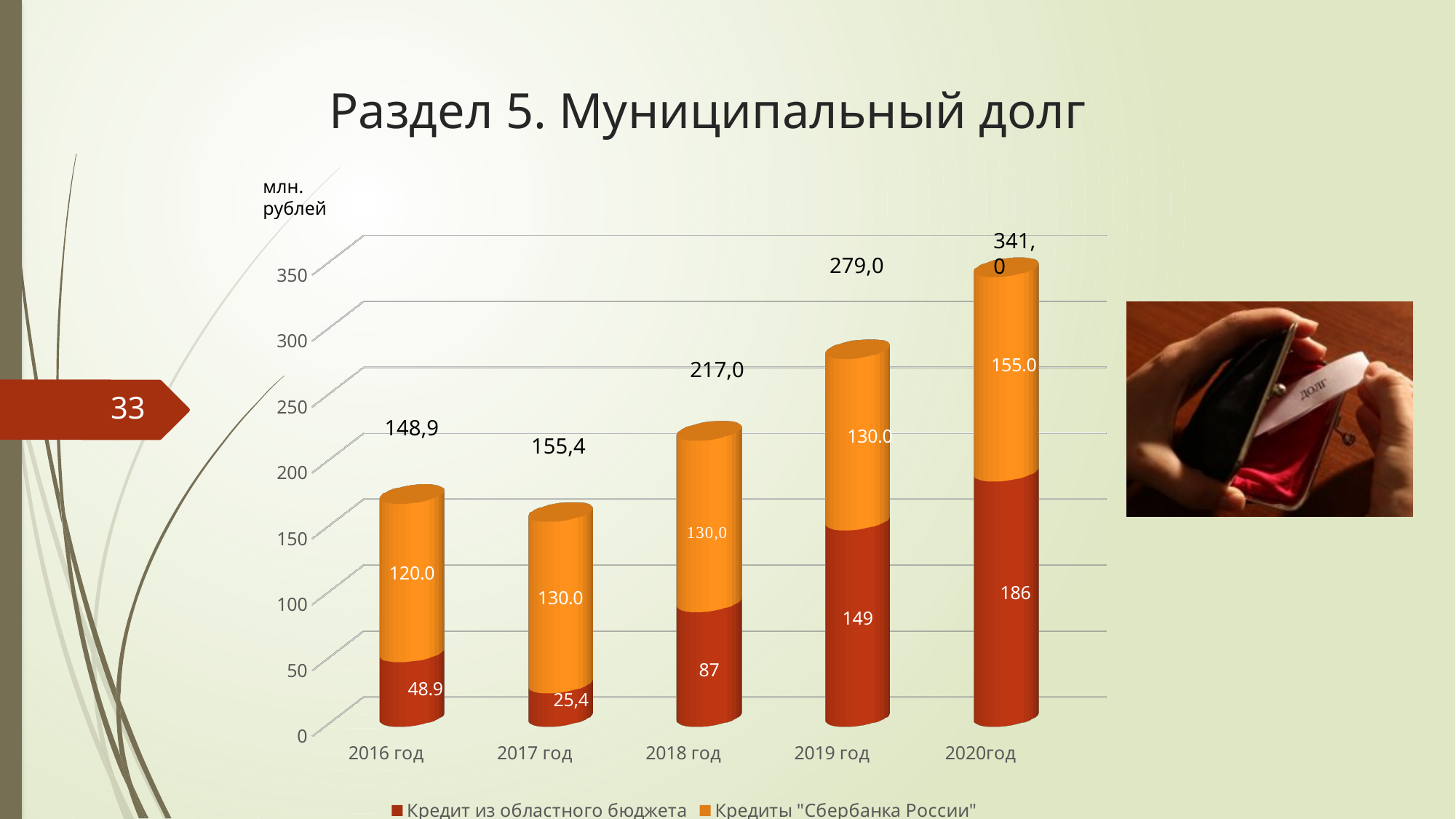
What is the value of "Кредит из областного бюджета" for 2019 год? 149 What is the difference between the "Кредит из областного бюджета" values for 2020год and 2019 год? 37 Which year has the highest total municipal debt? 2020год Which year has the lowest value for "Кредит из областного бюджета"? 2017 год How many series does the legend list? 2 What is the value of "Кредит из областного бюджета" for 2016 год? 48.9 Which is larger: the "Кредиты "Сбербанка России"" value for 2016 год or for 2017 год? 2017 год What type of chart is shown on the slide? stacked bar chart How many years (categories) are shown on the x axis? 5 What is the value of "Кредиты "Сбербанка России"" for 2020год? 155.0 What is the total of the stacked bar for 2018 год? 217,0 What is the total of the stacked bar for 2020год? 341,0